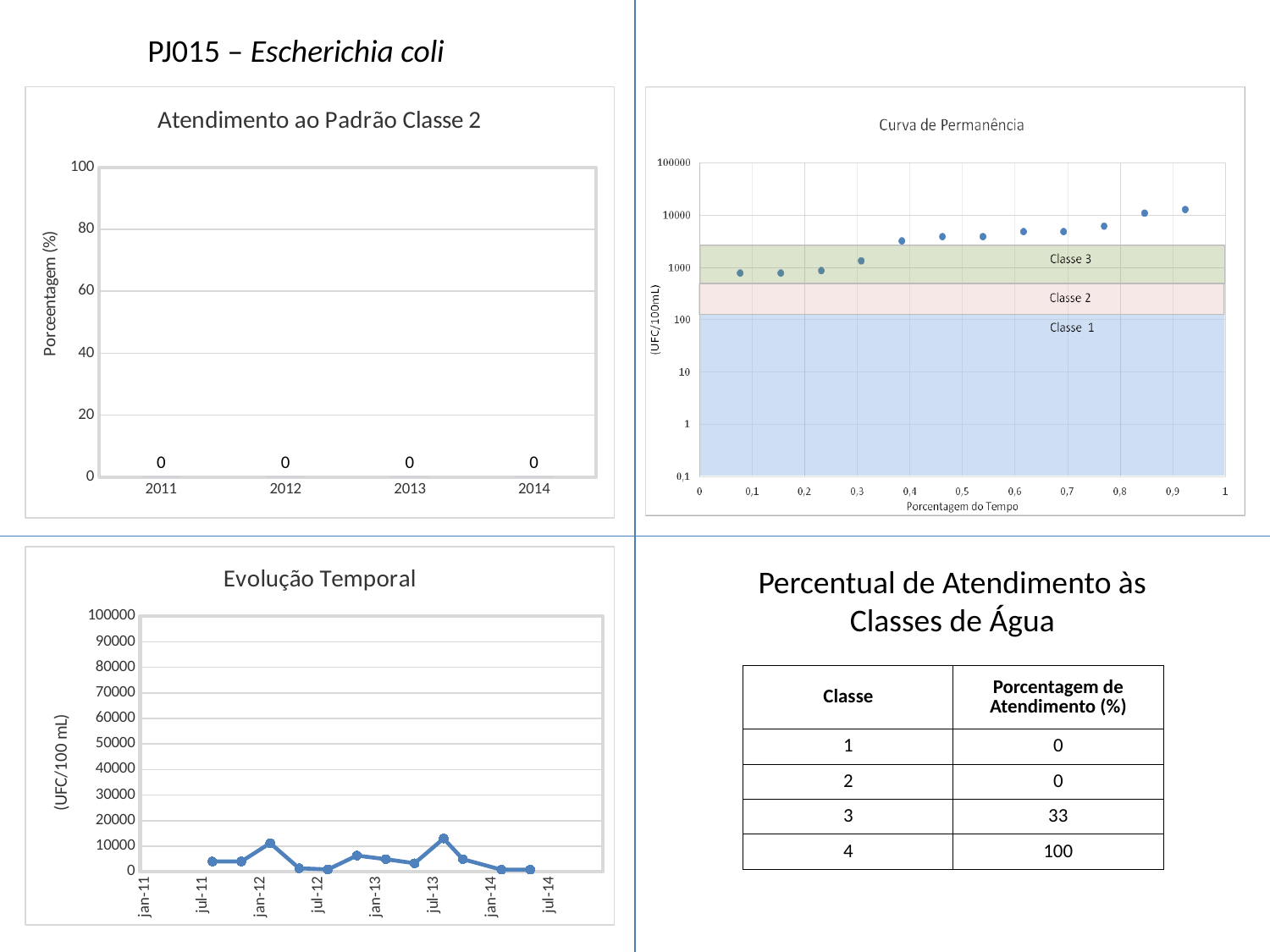
In the 'Curva de Permanência' chart, which class band is shaded at the bottom of the plot? Classe 1 In the 'Atendimento ao Padrão Classe 2' chart, what is the value for 2014? 0 In the 'Curva de Permanência' chart, is the value of the rightmost point (near 0.9) greater or less than 10000? greater In the 'Curva de Permanência' chart, is the value of the leftmost point (near 0.1) greater or less than 1000? less What is the y-axis label of the 'Atendimento ao Padrão Classe 2' chart? Porceentagem (%) How many data points are plotted in the 'Curva de Permanência' chart? 12 In the 'Atendimento ao Padrão Classe 2' chart, what is the value for 2012? 0 In the 'Evolução Temporal' chart, is the highest plotted value greater or less than 50000? less What kind of chart is 'Evolução Temporal'? line chart How many years are shown on the x axis of the 'Atendimento ao Padrão Classe 2' chart? 4 In the 'Curva de Permanência' chart, do the plotted values rise or fall as the percentage of time increases? rise What kind of chart is 'Atendimento ao Padrão Classe 2'? bar chart